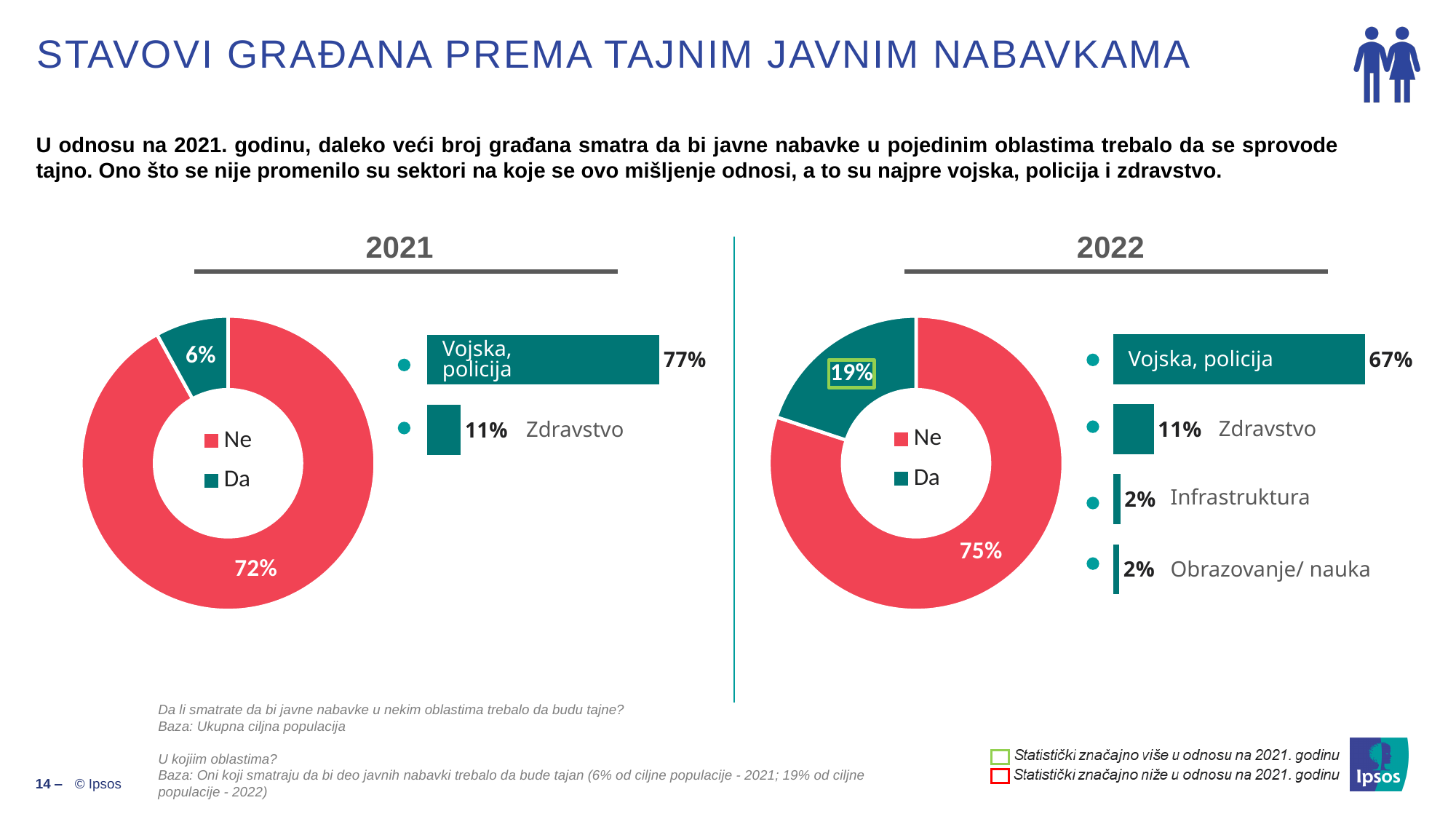
In the 2021 bar chart, what is the value for "Zdravstvo"? 11% In the 2022 donut chart, what percentage is shown for "Ne"? 75% How many entries does the legend of the 2021 donut chart list? 2 Which is larger: the value for "Vojska, policija" in the 2021 bar chart or in the 2022 bar chart? 2021 In the 2022 bar chart, what is the value for "Vojska, policija"? 67% In the 2021 donut chart, what percentage is shown for "Da"? 6% What type of chart is used to show the "Ne" and "Da" shares for 2021 and 2022? Donut (pie) chart How many categories are shown in the 2022 bar chart? 4 What is the difference between the "Da" share in the 2022 donut chart and the "Da" share in the 2021 donut chart? 13 percentage points In the 2022 bar chart, what is the value for "Infrastruktura"? 2% In the 2021 bar chart, which category has the lowest value? Zdravstvo In the 2022 bar chart, which category has the highest value? Vojska, policija